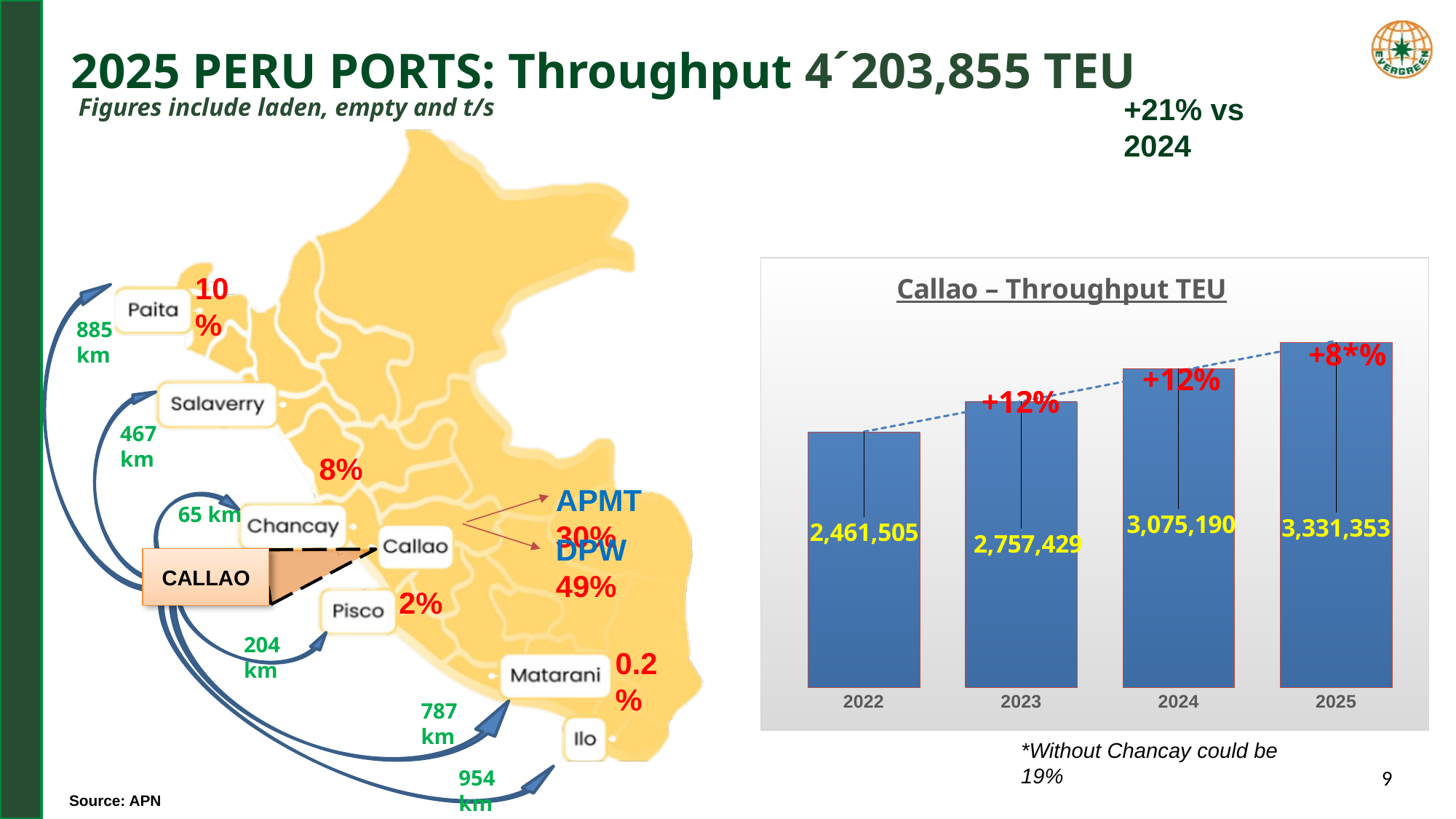
What is the Callao throughput in TEU for 2025? 3,331,353 Which year has the highest Callao throughput? 2025 What is the Callao throughput in TEU for 2024? 3,075,190 What kind of chart is the Callao – Throughput TEU chart? Bar chart Which year has the lowest Callao throughput? 2022 What is the Callao throughput in TEU for 2022? 2,461,505 What growth percentage is labelled above the 2025 bar in the Callao – Throughput TEU chart? +8*% Which year has the larger Callao throughput, 2023 or 2024? 2024 What is the difference in Callao throughput between 2023 and 2022? 295,924 How many years are shown in the Callao – Throughput TEU chart? 4 Does Callao throughput rise or fall from 2022 to 2025? Rise What is the difference in Callao throughput between 2025 and 2024? 256,163